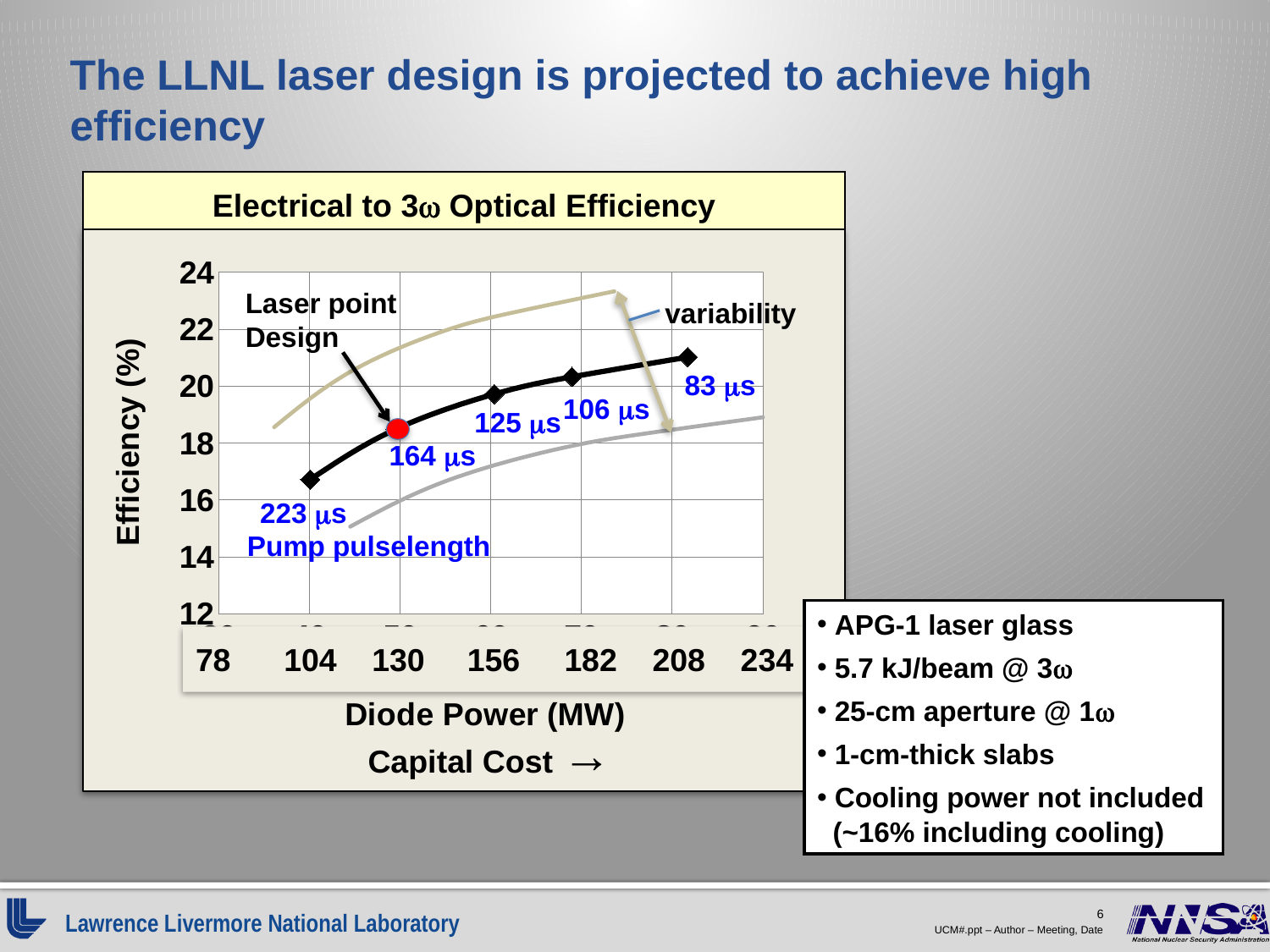
Is the efficiency at 104 MW diode power greater or less than 16? greater Is the efficiency at 104 MW diode power greater or less than 18? less What is the label of the x axis of the chart? Diode Power (MW) Is the efficiency at 208 MW diode power greater or less than 20? greater How many diamond/point markers are plotted on the black efficiency curve? 5 What pump pulselength is labelled at the Laser point Design (red point)? 164 μs What kind of chart is shown on the slide? line chart What is the title of the chart? Electrical to 3ω Optical Efficiency How many tick labels are shown on the Diode Power (MW) axis? 7 Does efficiency rise or fall as diode power increases along the x axis? rise